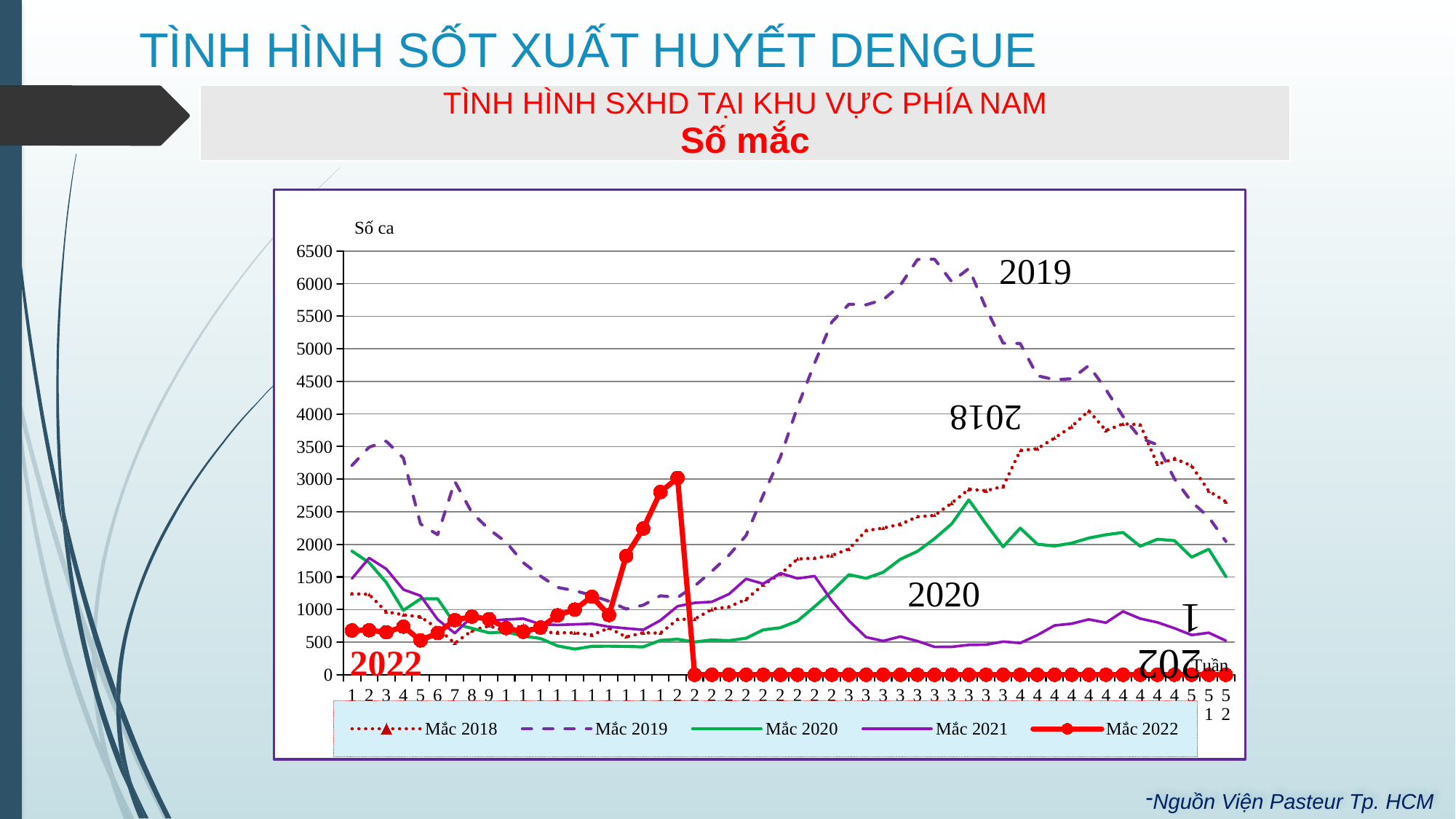
Does the Mắc 2022 line rise or fall between week 10 and week 20? rise Is the peak value of Mắc 2021 greater or less than 2500? less What kind of chart is shown on the slide? line chart How many series does the legend list? 5 What is the label of the vertical axis? Số ca What is the highest tick value shown on the vertical axis? 6500 Which series reaches the highest peak on the chart? Mắc 2019 At their respective peaks, which series is higher, Mắc 2018 or Mắc 2019? Mắc 2019 After its peak around week 33, does the Mắc 2019 line rise or fall toward week 52? fall Is the peak value of Mắc 2020 greater or less than 2000? greater Is the peak value of Mắc 2022 greater or less than 2500? greater